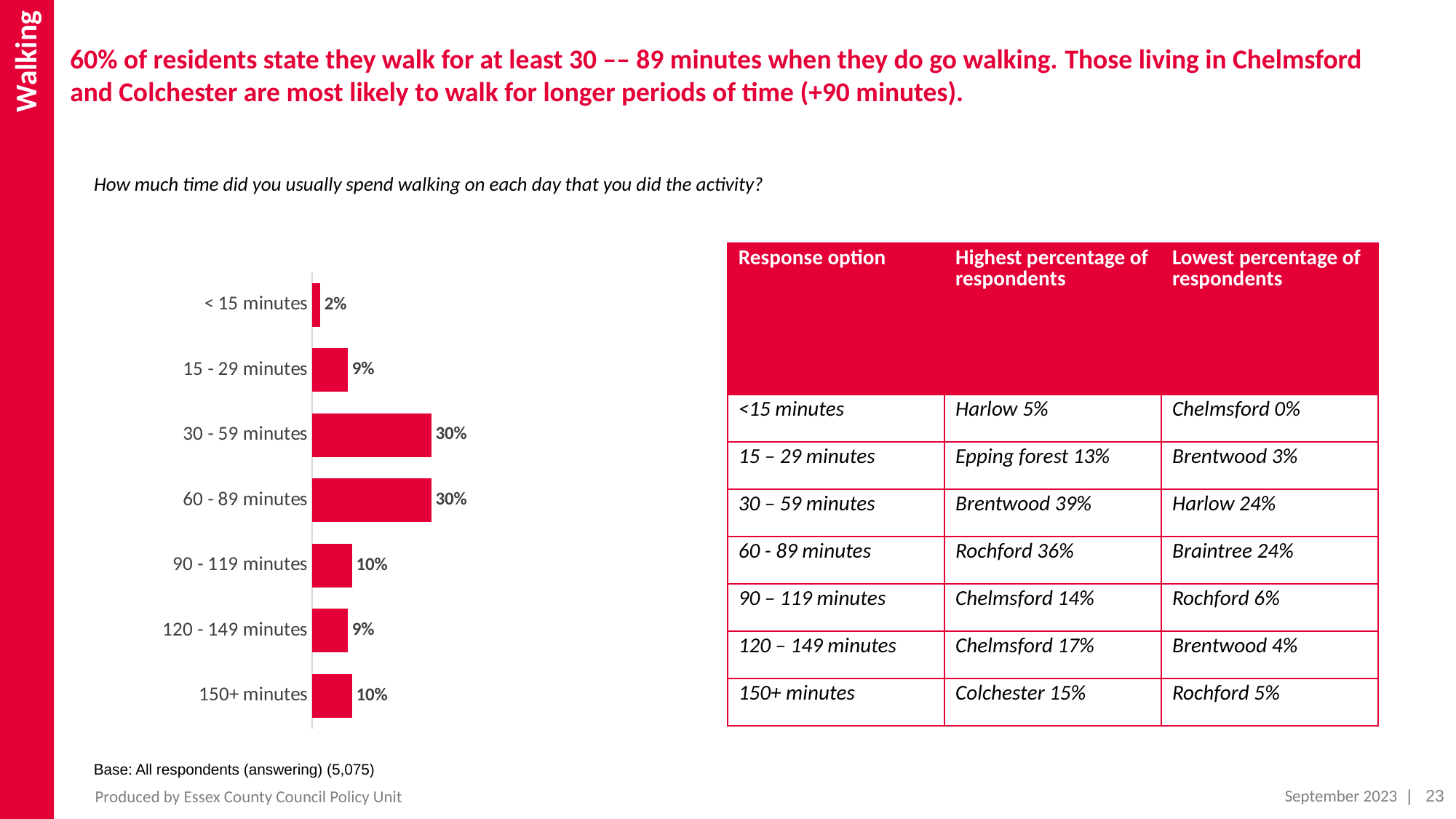
Which category has the lowest percentage of respondents? < 15 minutes What percentage of respondents said they usually walk for 150+ minutes? 10% What is the combined percentage for the 30 - 59 minutes and 60 - 89 minutes categories? 60% How many categories are shown in the bar chart? 7 What kind of chart is used to show the time spent walking? Bar chart What percentage of respondents said they usually walk for 30 - 59 minutes? 30% Which is larger, the value for 60 - 89 minutes or the value for 150+ minutes? 60 - 89 minutes What percentage of respondents said they usually walk for 120 - 149 minutes? 9% What is the difference in percentage points between the 90 - 119 minutes and < 15 minutes categories? 8 Which is larger, the value for 15 - 29 minutes or the value for 90 - 119 minutes? 90 - 119 minutes What percentage of respondents said they usually walk for < 15 minutes? 2% What is the difference in percentage points between the 30 - 59 minutes and 15 - 29 minutes categories? 21